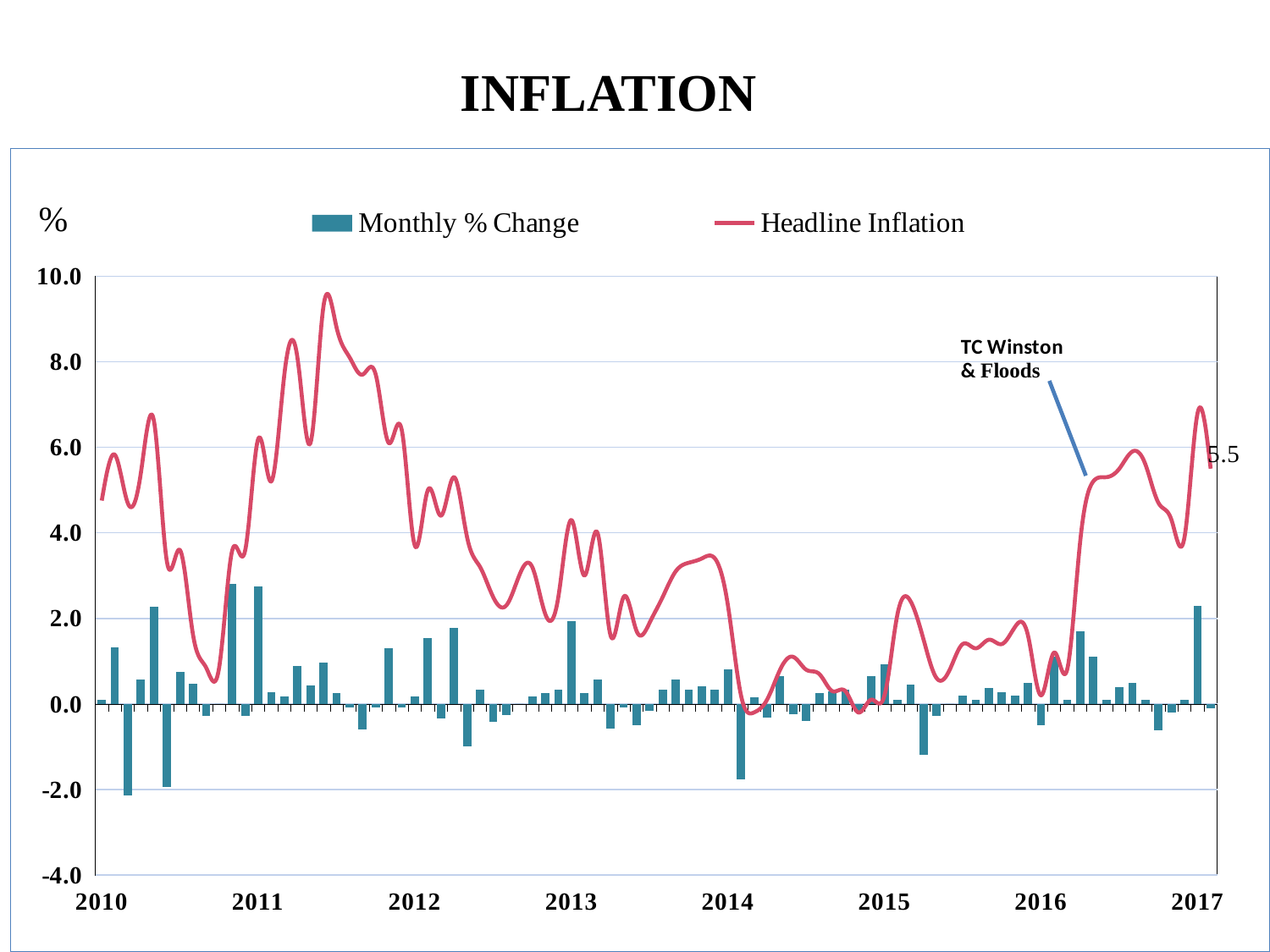
What is the title of the slide? INFLATION How many series does the legend list? 2 Is the Headline Inflation value at the start of 2010 greater or less than 4.0? greater In which year does the Headline Inflation line reach its highest point? 2011 Does the Headline Inflation line rise or fall between its 2011 peak and the start of 2014? fall What kind of chart is shown on the slide? A combined bar and line chart Is Headline Inflation higher in 2011 or in 2015? 2011 What is the data label shown at the end of the Headline Inflation line in 2017? 5.5 What event is annotated on the chart near 2016? TC Winston & Floods How many year labels are shown on the x axis? 8 Is the Headline Inflation value at the start of 2015 greater or less than 4.0? less Is the peak value of Headline Inflation in 2011 greater or less than 8.0? greater